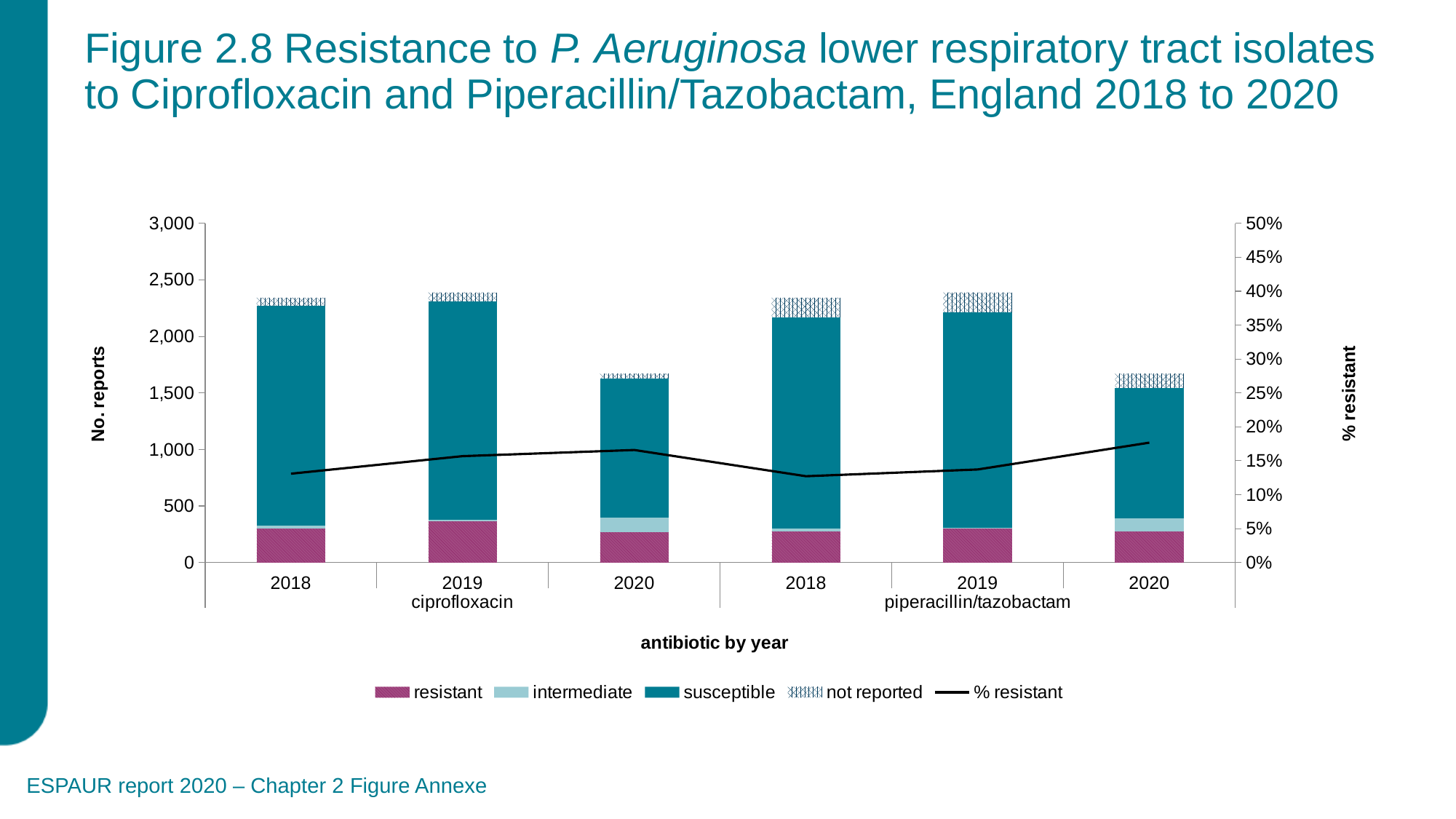
Is the total number of reports for ciprofloxacin in 2020 greater or less than 2,000? less Which has the larger total number of reports: ciprofloxacin in 2019 or ciprofloxacin in 2020? ciprofloxacin in 2019 How many bars are plotted in the chart? 6 Is the total number of reports for ciprofloxacin in 2019 greater or less than 2,000? greater What kind of chart is shown on the slide? A stacked bar chart with a line Is the % resistant for piperacillin/tazobactam in 2020 greater or less than 15%? greater What is the title of the horizontal axis? antibiotic by year How many series does the legend list? 5 What is the title of the left vertical axis? No. reports Does the % resistant line for piperacillin/tazobactam rise or fall from 2018 to 2020? rise